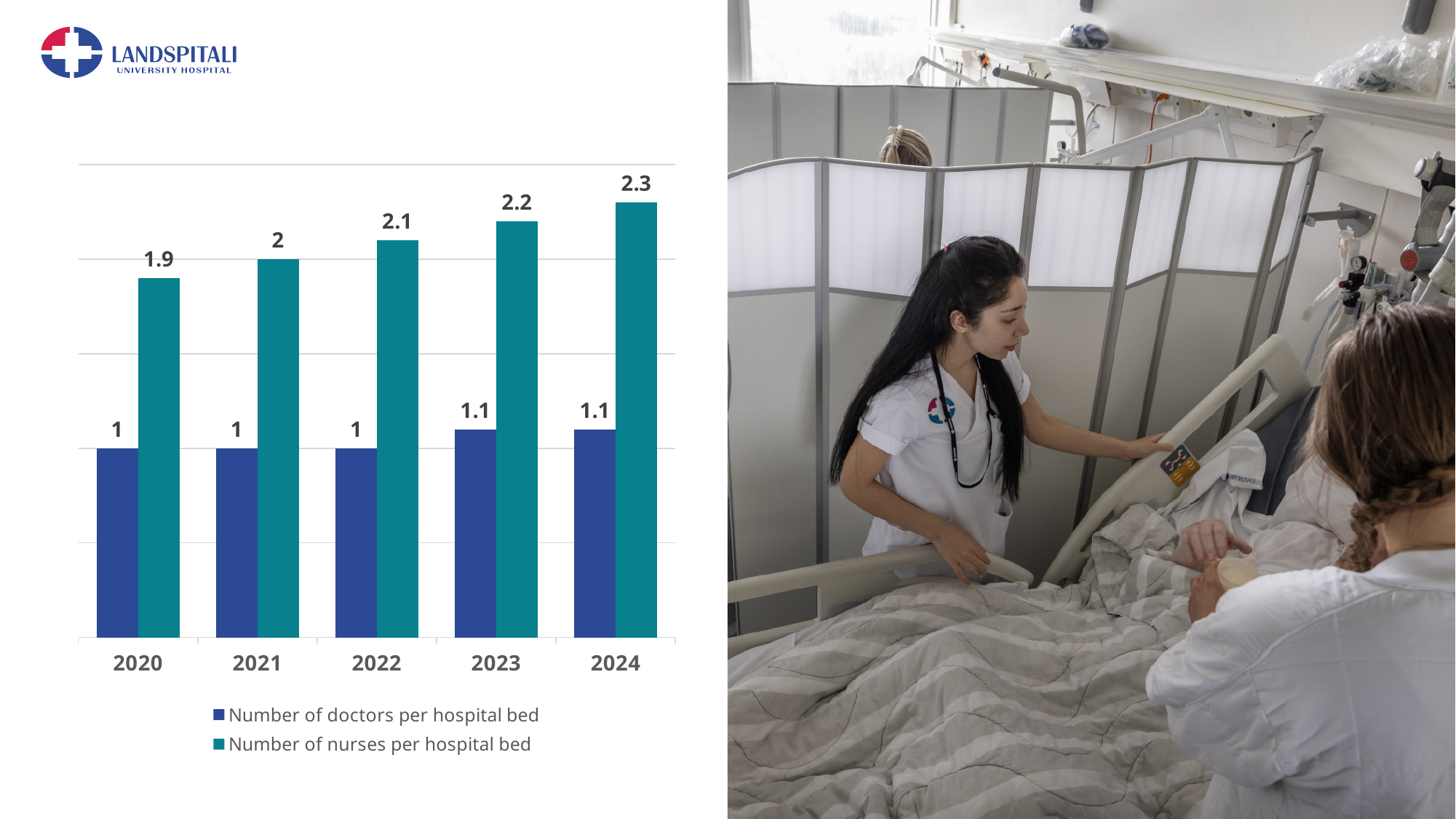
In which year is the number of nurses per hospital bed highest? 2024 What is the number of nurses per hospital bed in 2024? 2.3 In which year is the number of nurses per hospital bed lowest? 2020 How many years are shown on the x axis of the chart? 5 What is the number of nurses per hospital bed in 2020? 1.9 What is the difference between the number of nurses and the number of doctors per hospital bed in 2023? 1.1 Does the number of nurses per hospital bed rise or fall from 2020 to 2024? Rise What kind of chart is shown on the slide? Bar chart What is the number of doctors per hospital bed in 2021? 1 How many series does the chart legend list? 2 Which is larger in 2022: the number of doctors per hospital bed or the number of nurses per hospital bed? Number of nurses per hospital bed What is the difference between the number of nurses per hospital bed in 2024 and in 2020? 0.4